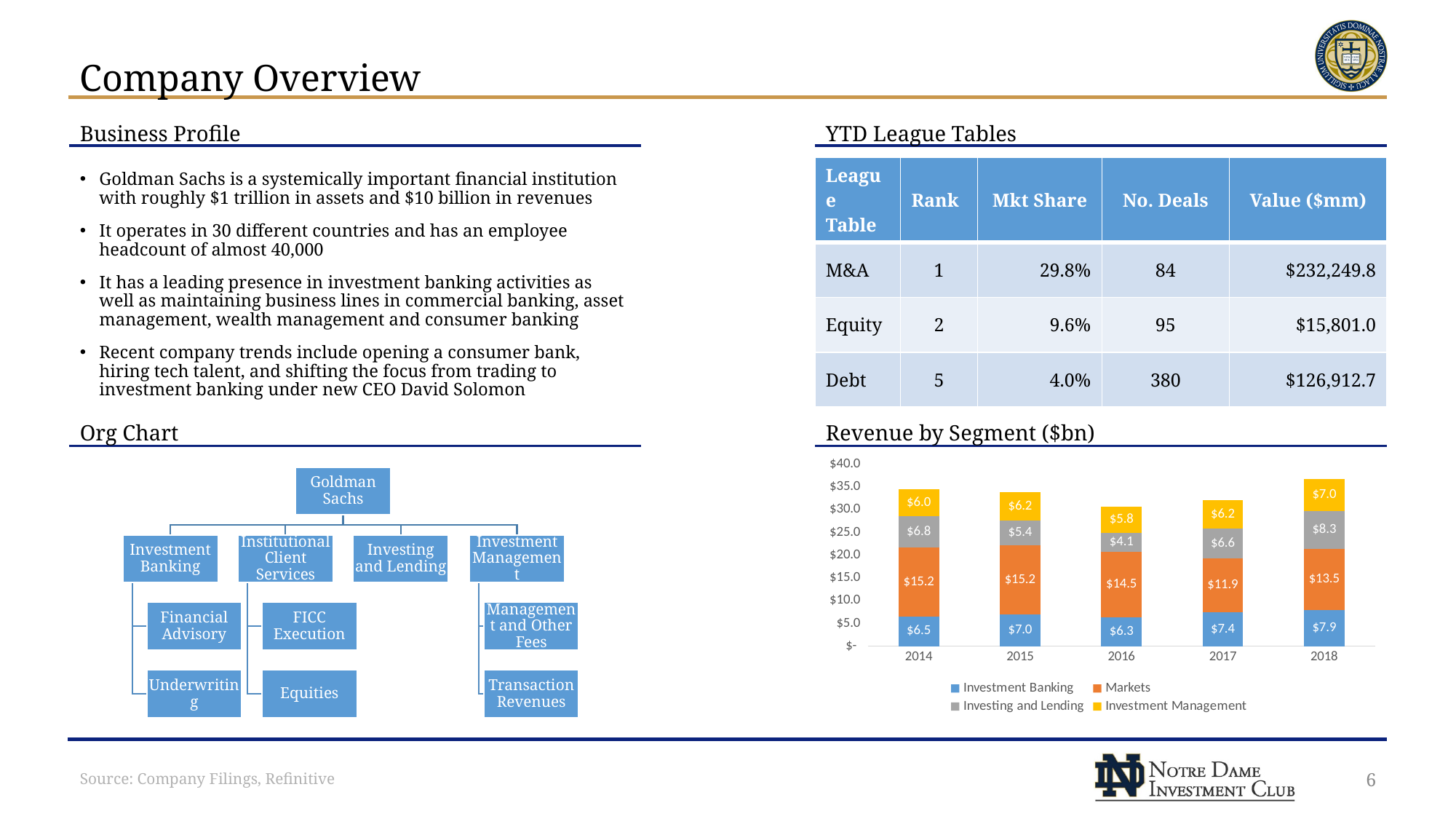
Which series is shown in orange in the Revenue by Segment ($bn) chart? Markets What is the total revenue across all segments for 2018 in the Revenue by Segment ($bn) chart? $36.7 What type of chart is the Revenue by Segment ($bn) chart? stacked bar chart How many years are shown on the x axis of the Revenue by Segment ($bn) chart? 5 What is the Markets revenue for 2016 in the Revenue by Segment ($bn) chart? $14.5 Which is larger in the Revenue by Segment ($bn) chart: Investment Management revenue in 2016 or in 2018? 2018 In which year is the Investing and Lending revenue highest in the Revenue by Segment ($bn) chart? 2018 In which year is the Markets revenue lowest in the Revenue by Segment ($bn) chart? 2017 How many series does the legend of the Revenue by Segment ($bn) chart list? 4 What is the difference between the Markets revenue in 2014 and in 2017 in the Revenue by Segment ($bn) chart? $3.3 What is the Investment Banking revenue for 2018 in the Revenue by Segment ($bn) chart? $7.9 What is the Investing and Lending revenue for 2015 in the Revenue by Segment ($bn) chart? $5.4